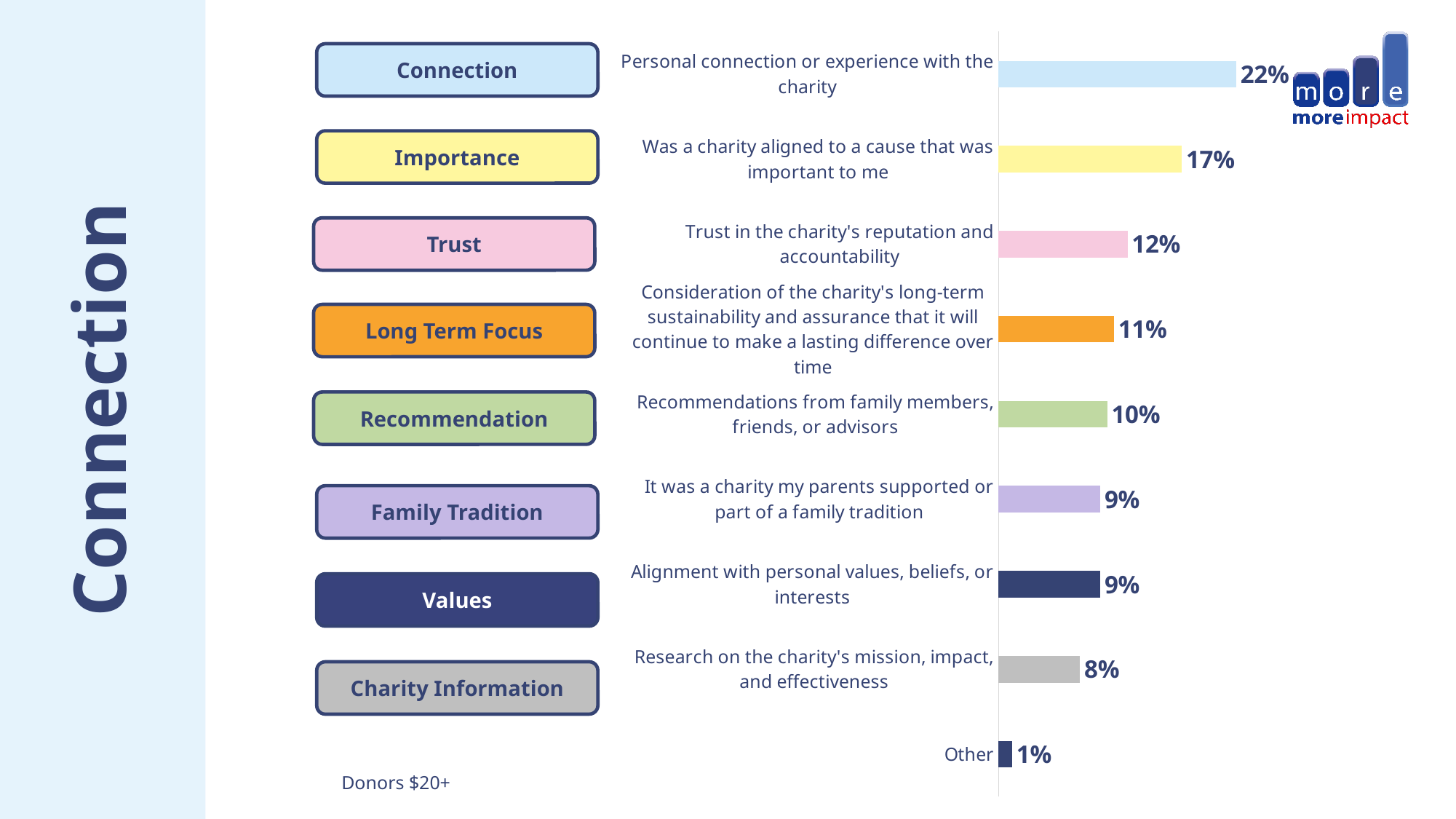
Which category has the lowest value in the chart? Other What value is shown for 'Trust in the charity's reputation and accountability'? 12% Which is larger: the value for 'Recommendations from family members, friends, or advisors' or the value for 'Consideration of the charity's long-term sustainability...'? Consideration of the charity's long-term sustainability What is the difference between the value for 'Personal connection or experience with the charity' and 'Was a charity aligned to a cause that was important to me'? 5% What percentage is shown for 'Research on the charity's mission, impact, and effectiveness'? 8% Which category has the highest value in the chart? Personal connection or experience with the charity What is the difference between the value for 'Trust in the charity's reputation and accountability' and 'Research on the charity's mission, impact, and effectiveness'? 4% What kind of chart is shown on the slide? Bar chart What value is shown for the 'Other' category? 1% What percentage is shown for 'Personal connection or experience with the charity'? 22% What label is shown in the box next to the bar for 'Alignment with personal values, beliefs, or interests'? Values How many categories (bars) are plotted in the chart? 9